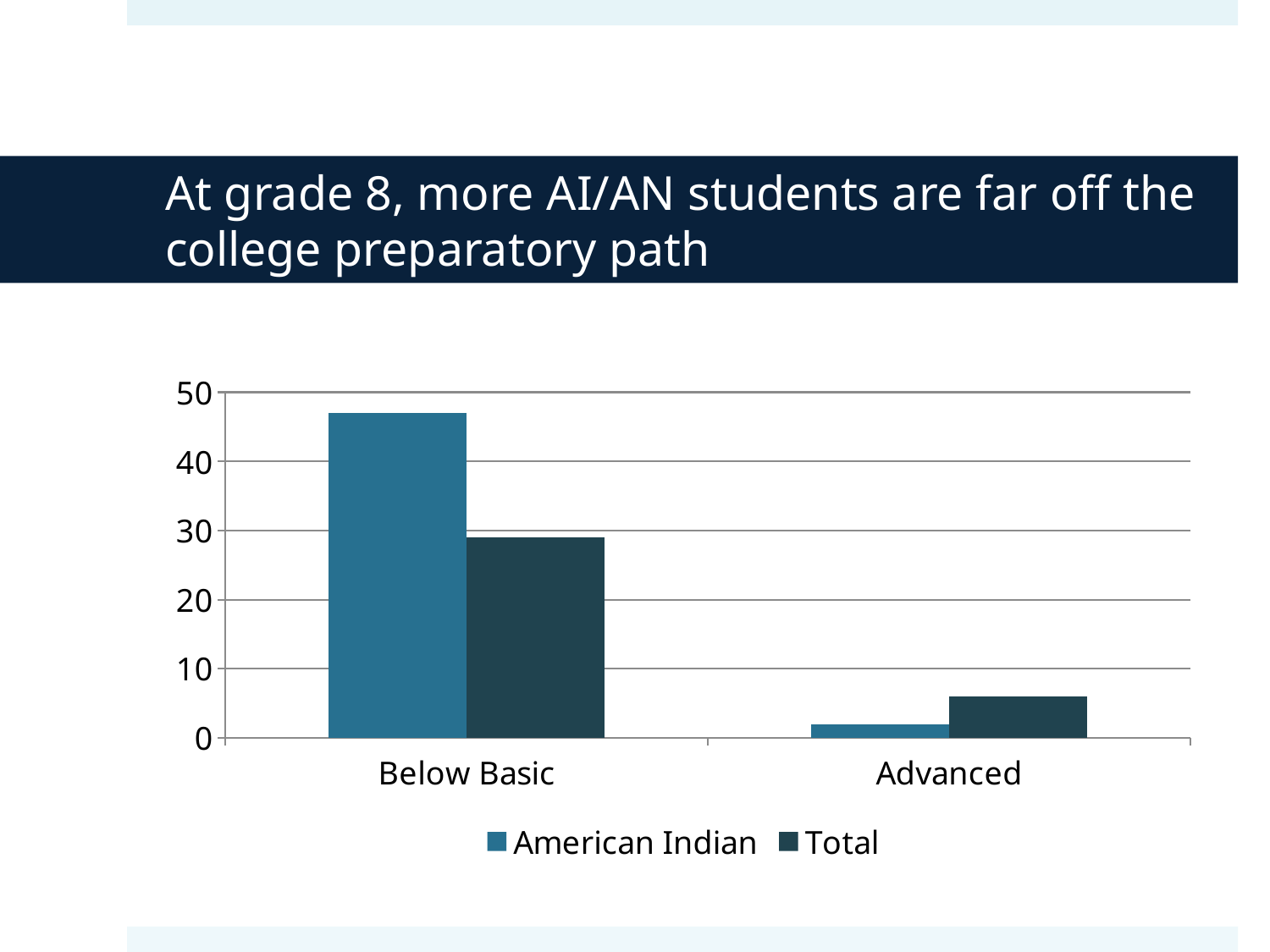
Is the Total value for Advanced greater or less than 10? less Which series has the higher value for Below Basic, American Indian or Total? American Indian Is the American Indian value for Advanced greater or less than 10? less How many categories are shown on the x axis? 2 Which series has the higher value for Advanced, American Indian or Total? Total Is the American Indian value for Below Basic greater or less than 40? greater What are the two series named in the legend? American Indian and Total How many series does the legend list? 2 Which category has the lowest Total value? Advanced Which category has the highest American Indian value? Below Basic What kind of chart is shown on the slide? bar chart